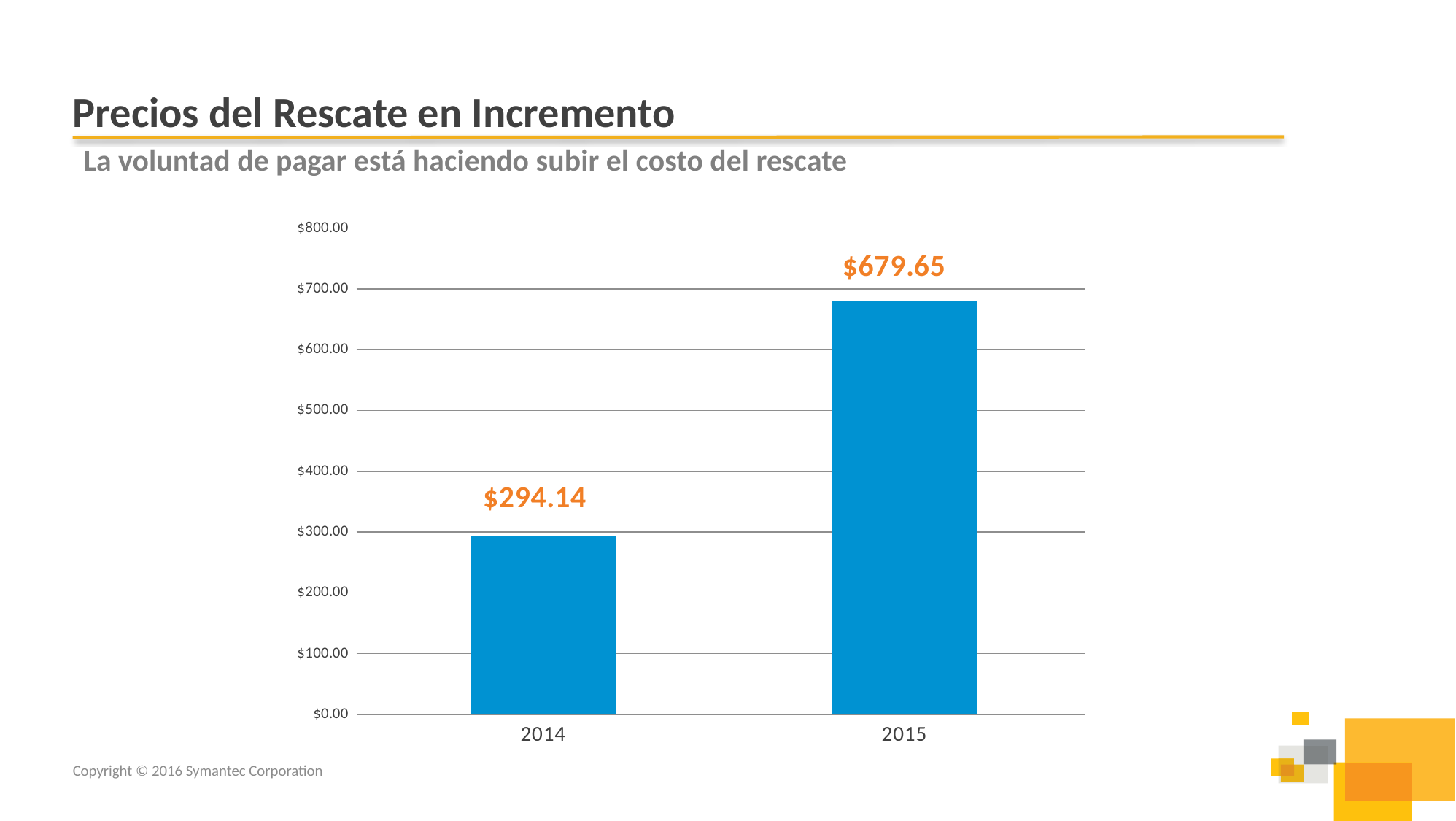
What is the value for 2015? $679.65 What kind of chart is shown on the slide? bar chart Is the value for 2015 greater or less than $600.00? greater Which is larger, the value for 2014 or the value for 2015? 2015 Do the values rise or fall from 2014 to 2015? rise Is the value for 2014 greater or less than $300.00? less How many categories are shown on the x axis? 2 What is the maximum value shown on the y axis? $800.00 Which year has the lowest value? 2014 What is the difference between the values for 2015 and 2014? $385.51 Which year has the highest value? 2015 What is the value for 2014? $294.14